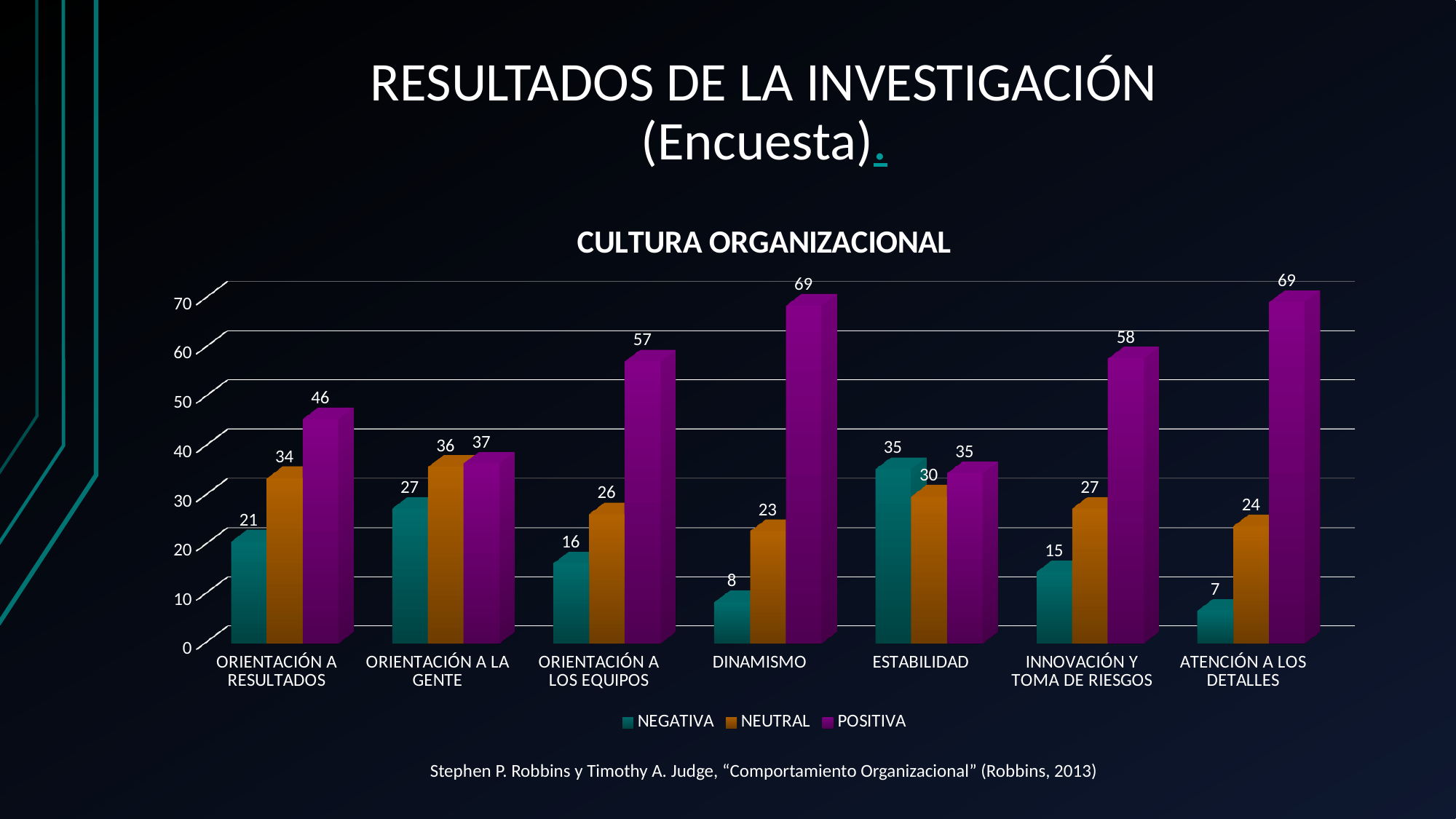
Which category has the lowest NEUTRAL value? DINAMISMO Which category has the lowest NEGATIVA value? ATENCIÓN A LOS DETALLES What is the difference between the POSITIVA and NEGATIVA values for DINAMISMO? 61 What is the NEGATIVA value for ORIENTACIÓN A RESULTADOS? 21 What is the title of the chart? CULTURA ORGANIZACIONAL Which category has the highest NEGATIVA value? ESTABILIDAD What is the POSITIVA value for ORIENTACIÓN A LOS EQUIPOS? 57 What kind of chart is shown? Bar chart How many categories are shown on the x axis? 7 How many series does the legend list? 3 Which is larger for ORIENTACIÓN A LA GENTE: the NEUTRAL value or the POSITIVA value? POSITIVA What is the NEUTRAL value for INNOVACIÓN Y TOMA DE RIESGOS? 27